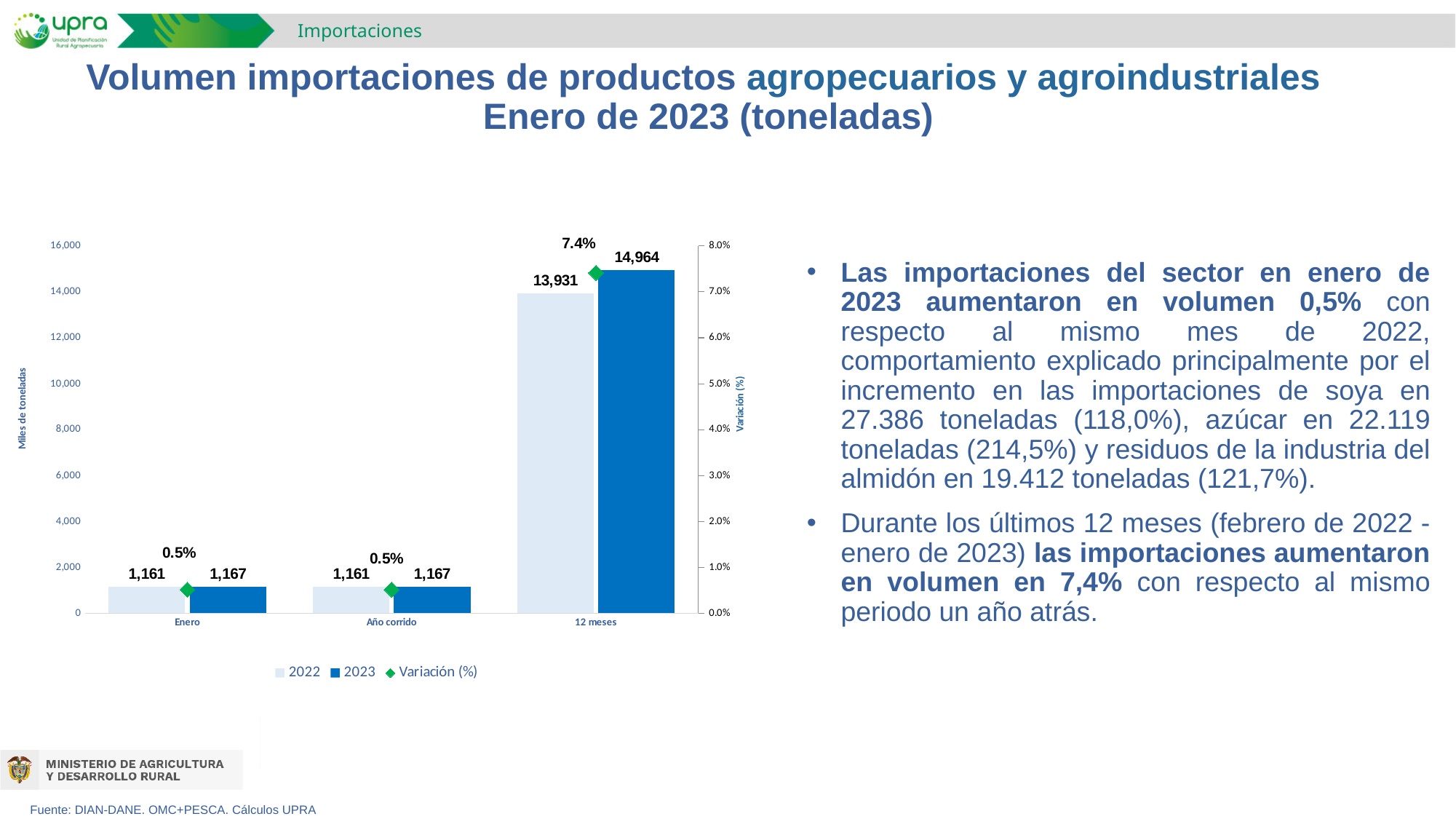
Is the 2022 value for 12 meses greater or less than 12,000? greater How many series does the legend list? 3 How many categories are shown on the x axis? 3 What is the difference between the 2023 and 2022 values for 12 meses? 1,033 Which category has the highest 2023 value? 12 meses What is the label of the left vertical axis? Miles de toneladas What is the 2023 value for 12 meses? 14,964 What is the Variación (%) value for Año corrido? 0.5% What is the 2022 value for Enero? 1,161 What is the Variación (%) value for 12 meses? 7.4% Which is larger for 12 meses, the 2022 value or the 2023 value? 2023 What is the difference between the 2023 and 2022 values for Enero? 6